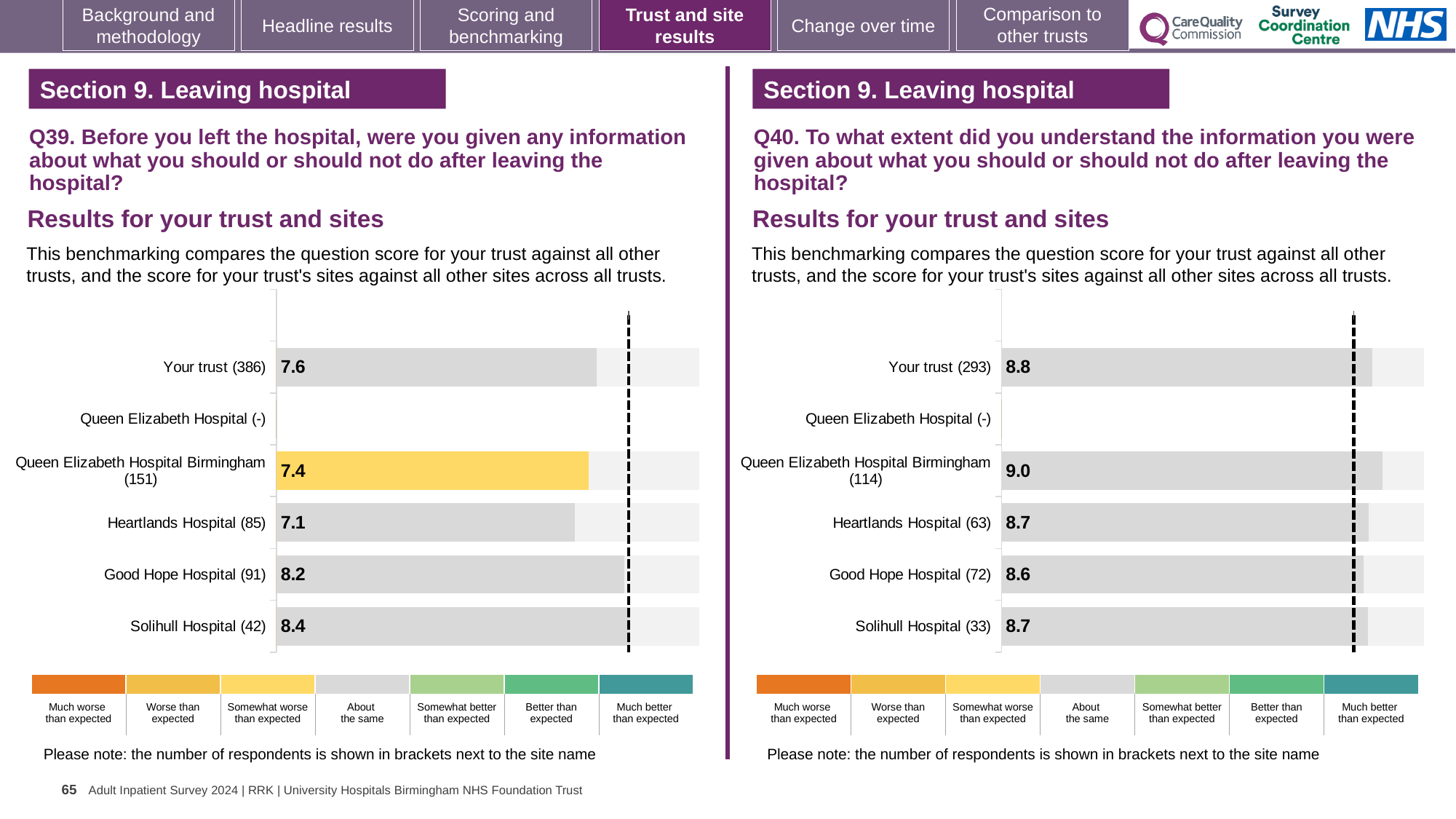
In the Q40 chart on the right, what is the score for Good Hope Hospital (72)? 8.6 In the Q40 chart on the right, which is larger: the score for Heartlands Hospital or Good Hope Hospital? Heartlands Hospital In the Q39 chart on the left, what is the score for Heartlands Hospital (85)? 7.1 In the Q39 chart on the left, what is the difference between the scores for Solihull Hospital and Queen Elizabeth Hospital Birmingham? 1.0 In the Q39 chart on the left, what is the score for Your trust (386)? 7.6 In the Q40 chart on the right, what is the score for Your trust (293)? 8.8 What type of chart is used on this slide? Bar chart In the Q39 chart on the left, which site has the lowest score? Heartlands Hospital (85) In the Q40 chart on the right, which site has the highest score? Queen Elizabeth Hospital Birmingham (114) In the Q39 chart on the left, which bar is coloured yellow, indicating 'Somewhat worse than expected'? Queen Elizabeth Hospital Birmingham (151) In the Q39 chart on the left, which site has the highest score? Solihull Hospital (42) In the Q40 chart on the right, what is the difference between the scores for Queen Elizabeth Hospital Birmingham and Good Hope Hospital? 0.4